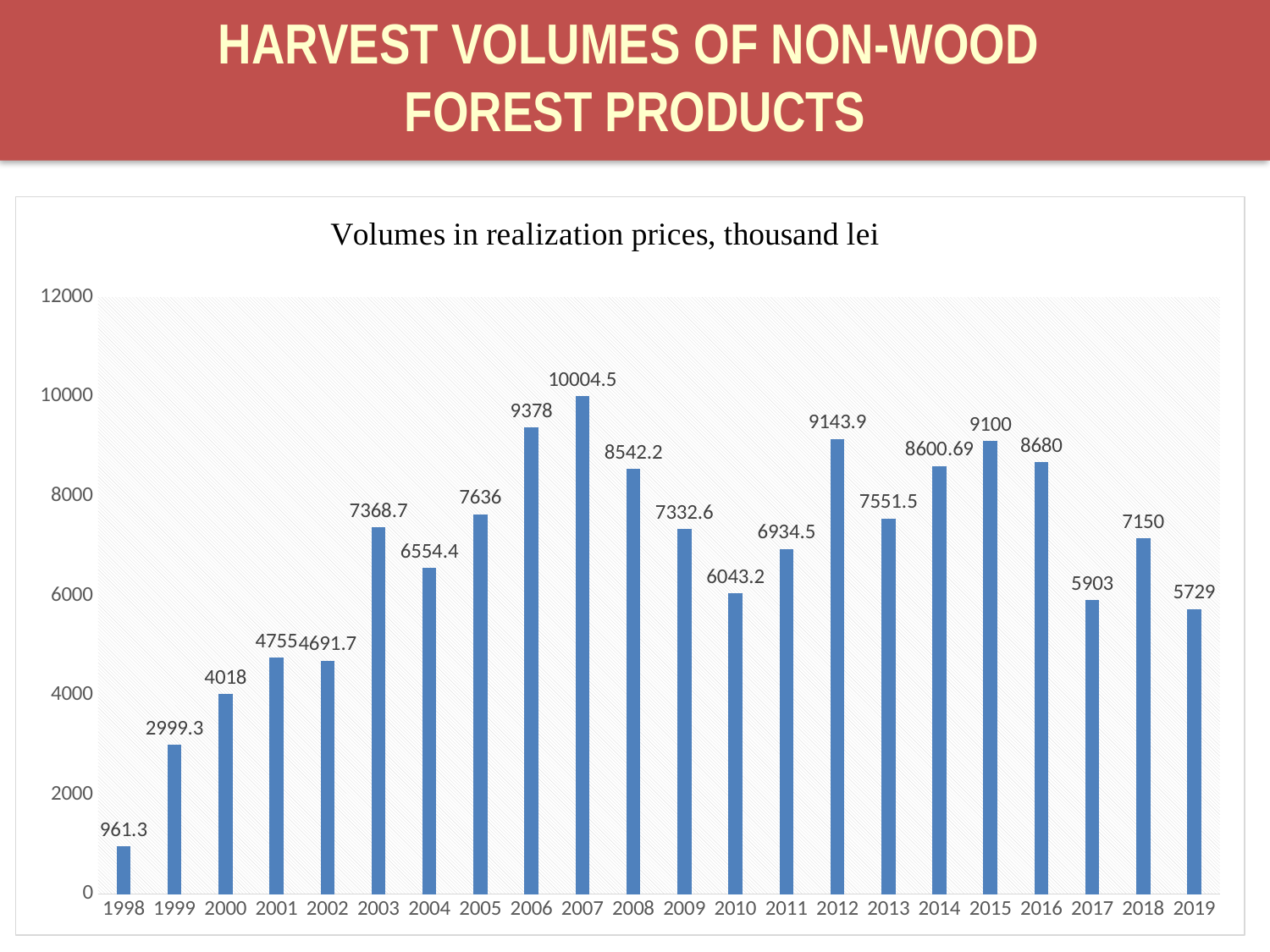
Is the value for 2003 greater or less than 6000? greater What is the value for 2007? 10004.5 Which is larger, the value for 2006 or the value for 2016? 2006 Which year has the lowest value? 1998 What is the title of the chart? Volumes in realization prices, thousand lei How many years are shown on the x axis? 22 What is the value for 1998? 961.3 What is the difference between the values for 2018 and 2019? 1421 What is the value for 2014? 8600.69 What is the difference between the values for 2007 and 2006? 626.5 Which year has the highest value? 2007 What kind of chart is this? bar chart